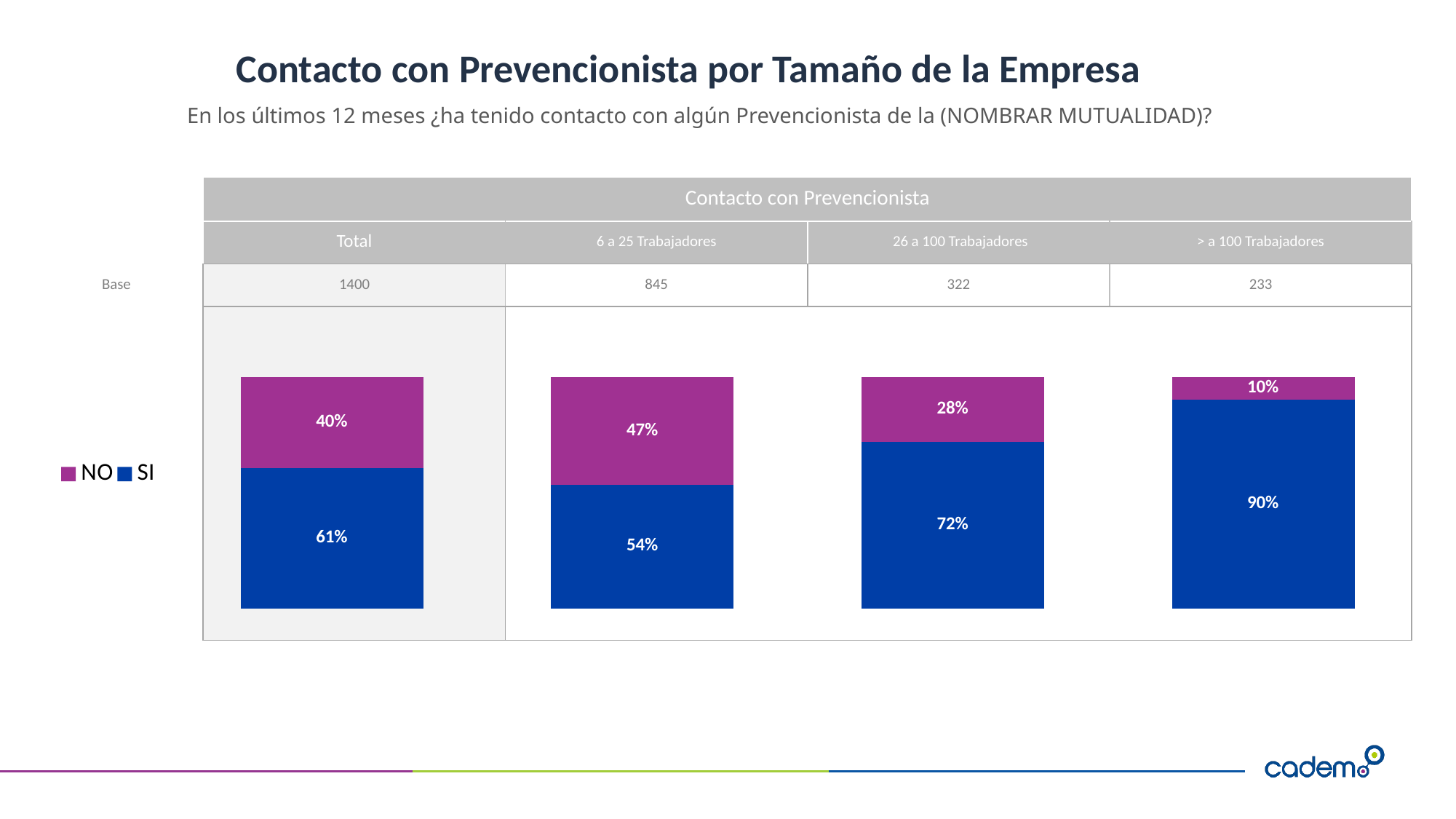
Which category has the lowest SI value? 6 a 25 Trabajadores What is the difference between the SI values for > a 100 Trabajadores and 6 a 25 Trabajadores? 36% How many categories (columns) are shown in the chart? 4 Which category has the highest SI value? > a 100 Trabajadores What is the SI value for 26 a 100 Trabajadores? 72% Which is larger, the NO value for 6 a 25 Trabajadores or the NO value for 26 a 100 Trabajadores? 6 a 25 Trabajadores What is the SI value for the Total column? 61% What kind of chart is shown on the slide? Stacked bar chart What is the Base for 26 a 100 Trabajadores? 322 What is the NO value for > a 100 Trabajadores? 10% How many series does the legend list? 2 What is the NO value for 6 a 25 Trabajadores? 47%